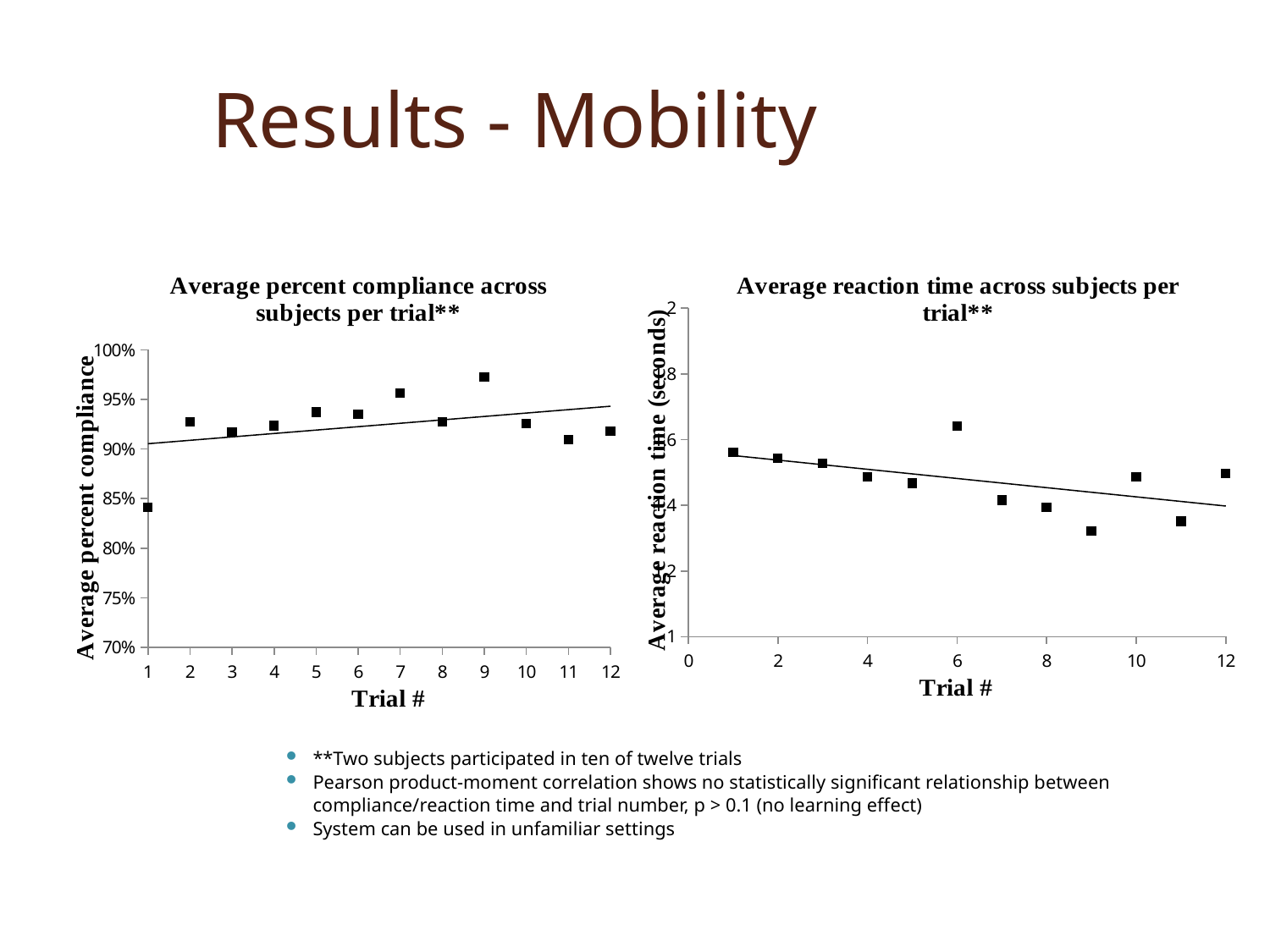
In the right chart, 'Average reaction time across subjects per trial**', which trial has the highest average reaction time? Trial 6 In the right chart, 'Average reaction time across subjects per trial**', which trial has the lowest average reaction time? Trial 9 In the right chart, 'Average reaction time across subjects per trial**', is the value for trial 6 greater or less than 1.6 seconds? greater In the left chart, 'Average percent compliance across subjects per trial**', which trial has the lowest average percent compliance? Trial 1 In the left chart, 'Average percent compliance across subjects per trial**', how many trials are plotted? 12 In the left chart, 'Average percent compliance across subjects per trial**', is the value for trial 1 greater or less than 85%? less In the left chart, 'Average percent compliance across subjects per trial**', does the fitted trend line rise or fall as the trial number increases? rises In the left chart, 'Average percent compliance across subjects per trial**', which trial has the highest average percent compliance? Trial 9 In the left chart, 'Average percent compliance across subjects per trial**', is the value for trial 7 greater or less than 95%? greater What kind of chart is the left chart, 'Average percent compliance across subjects per trial**'? scatter chart In the right chart, 'Average reaction time across subjects per trial**', which has the larger average reaction time, trial 1 or trial 9? Trial 1 What is the y-axis label of the right chart, 'Average reaction time across subjects per trial**'? Average reaction time (seconds)